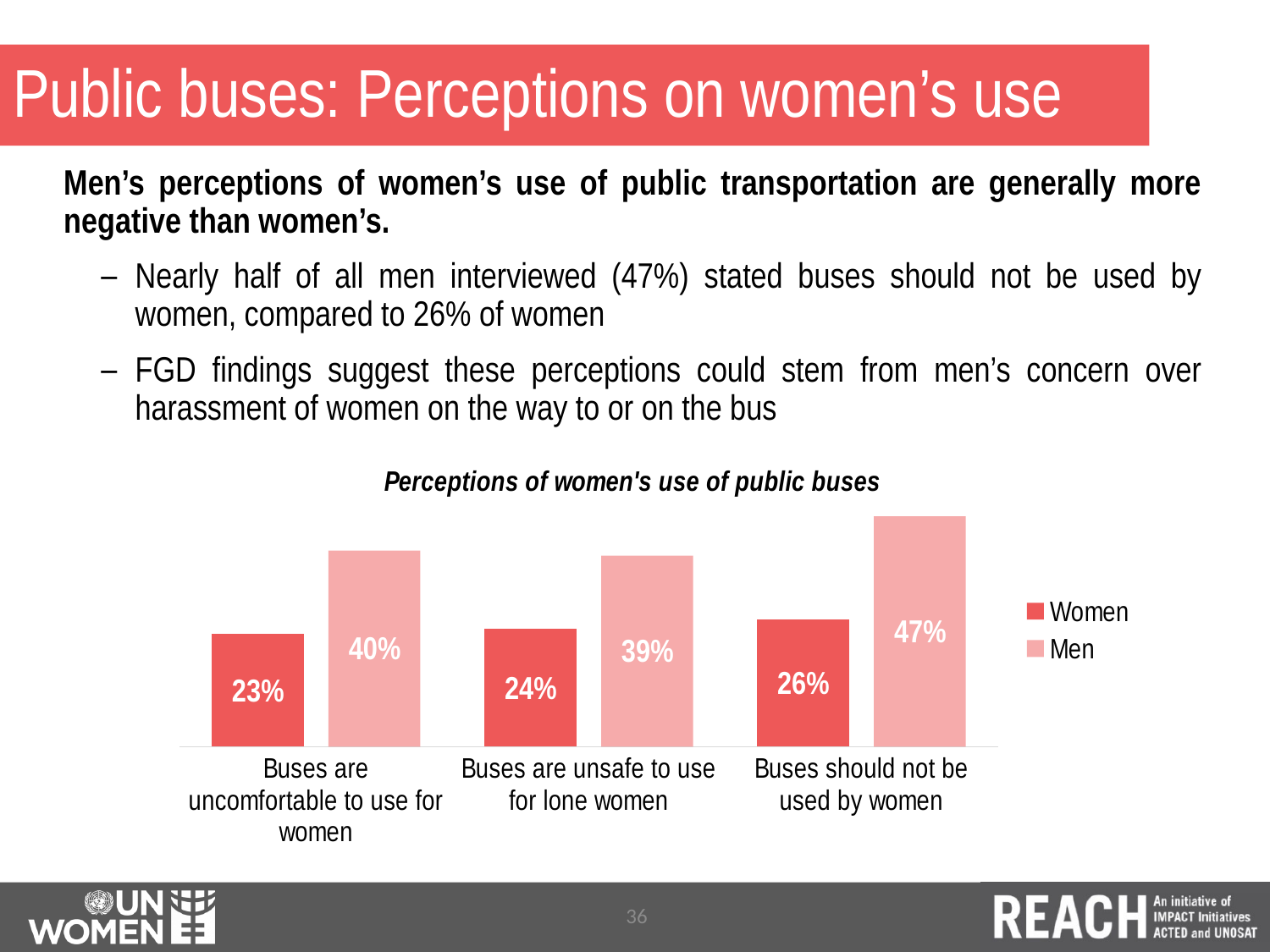
What percentage of women said buses should not be used by women? 26% What percentage of women said buses are uncomfortable to use for women? 23% Which category has the lowest value for women? Buses are uncomfortable to use for women How many categories are shown on the x axis of the chart? 3 What type of chart is shown on the slide? Bar chart What percentage of men said buses are unsafe to use for lone women? 39% How many series does the chart legend list? 2 What is the difference between the men's and women's values for 'Buses should not be used by women'? 21% What is the difference between the men's and women's values for 'Buses are uncomfortable to use for women'? 17% Which category has the highest value for men? Buses should not be used by women What percentage of men said buses should not be used by women? 47% For 'Buses are unsafe to use for lone women', which is larger, the value for women or for men? Men